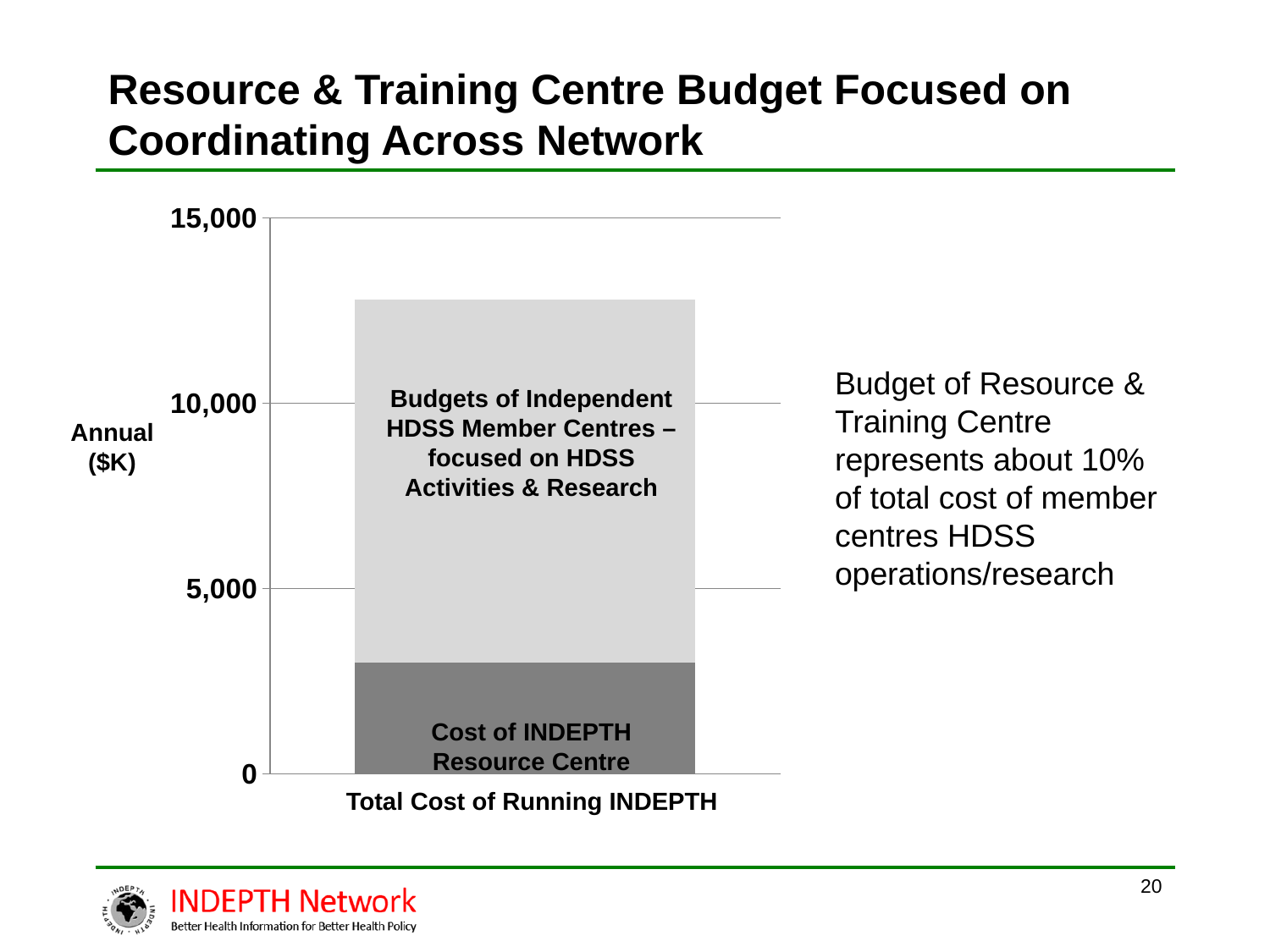
Which segment of the stacked bar is the largest? Budgets of Independent HDSS Member Centres Is the total height of the stacked bar for Total Cost of Running INDEPTH greater or less than 15,000? less Which segment of the stacked bar is larger: Cost of INDEPTH Resource Centre or Budgets of Independent HDSS Member Centres? Budgets of Independent HDSS Member Centres Which segment of the stacked bar is the smallest? Cost of INDEPTH Resource Centre Is the value of the Cost of INDEPTH Resource Centre segment greater or less than 5,000? less What is the label of the category on the x axis of the chart? Total Cost of Running INDEPTH How many segments make up the stacked bar in the chart? 2 Is the total height of the stacked bar for Total Cost of Running INDEPTH greater or less than 10,000? greater What kind of chart is shown on the slide? bar chart How many categories are plotted on the x axis of the chart? 1 What is the label of the y axis of the chart? Annual ($K)